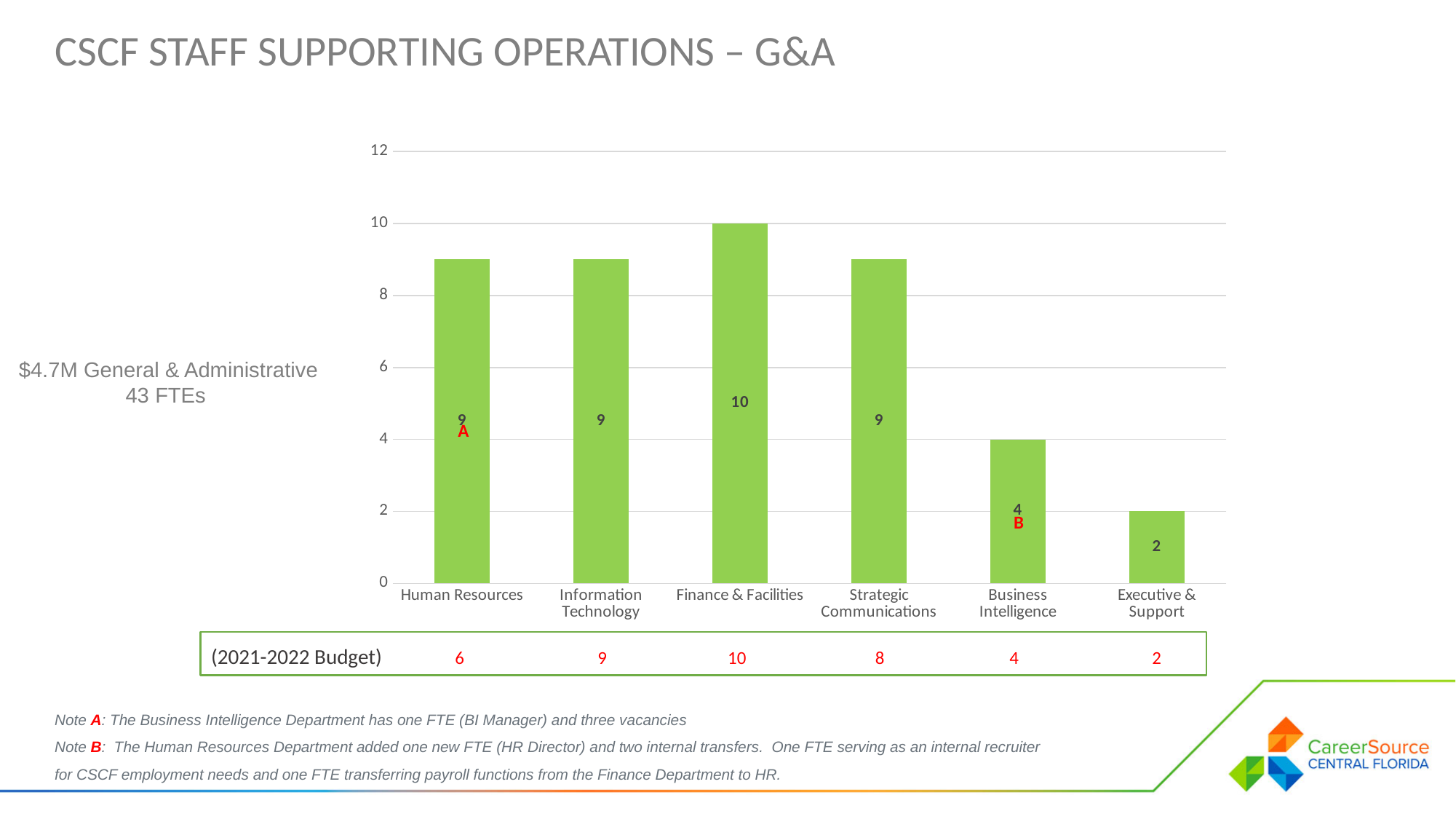
Which category has the highest value? Finance & Facilities Which is larger, the value for Strategic Communications or the value for Executive & Support? Strategic Communications What is the 2021-2022 Budget figure shown below the chart for Human Resources? 6 Is the value for Information Technology greater or less than 6? greater What is the value for Business Intelligence? 4 What is the difference between the values for Finance & Facilities and Business Intelligence? 6 What is the value for Executive & Support? 2 Which category has the lowest value? Executive & Support What kind of chart is shown on the slide? bar chart How many categories are shown on the chart? 6 What is the value for Finance & Facilities? 10 What colour are the bars in the chart? green